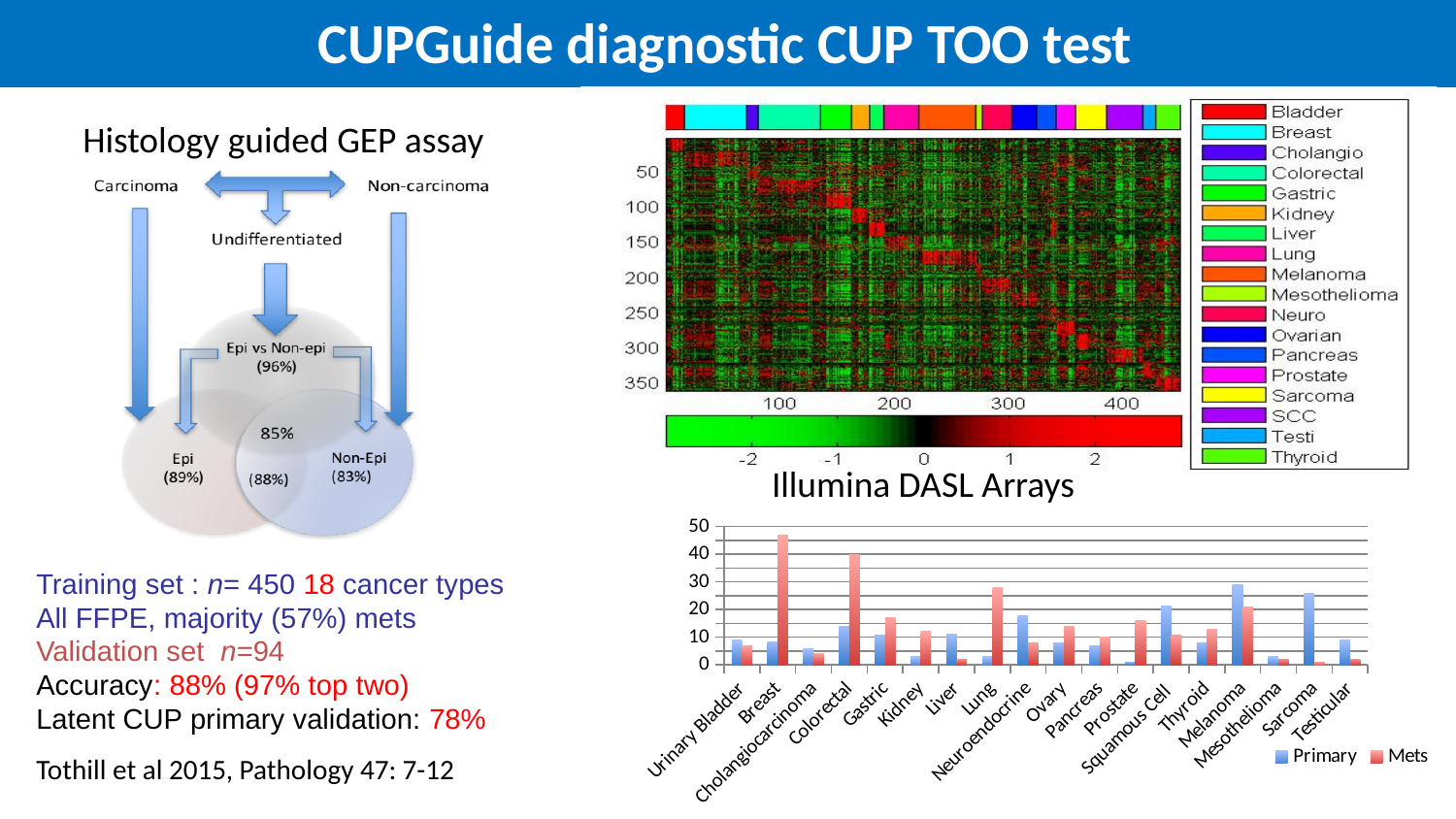
What kind of chart is the chart at the bottom right of the slide (with Primary and Mets)? bar chart What is the title shown below the heatmap on the right of the slide? Illumina DASL Arrays In the bottom-right bar chart, is the Mets value for Lung greater or less than 20? greater In the bottom-right bar chart, what colour represents the Mets series? red In the bottom-right bar chart, is the Mets value for Breast greater or less than 40? greater In the bottom-right bar chart, which category has the highest Mets value? Breast In the bottom-right bar chart, how many cancer type categories are shown on the x axis? 18 In the bottom-right bar chart, which is larger for Colorectal, Primary or Mets? Mets In the bottom-right bar chart, which is larger for Breast, Primary or Mets? Mets In the bottom-right bar chart, which is larger for Sarcoma, Primary or Mets? Primary In the bottom-right bar chart, is the Primary value for Sarcoma greater or less than 20? greater In the bottom-right bar chart, how many series does the legend list? 2